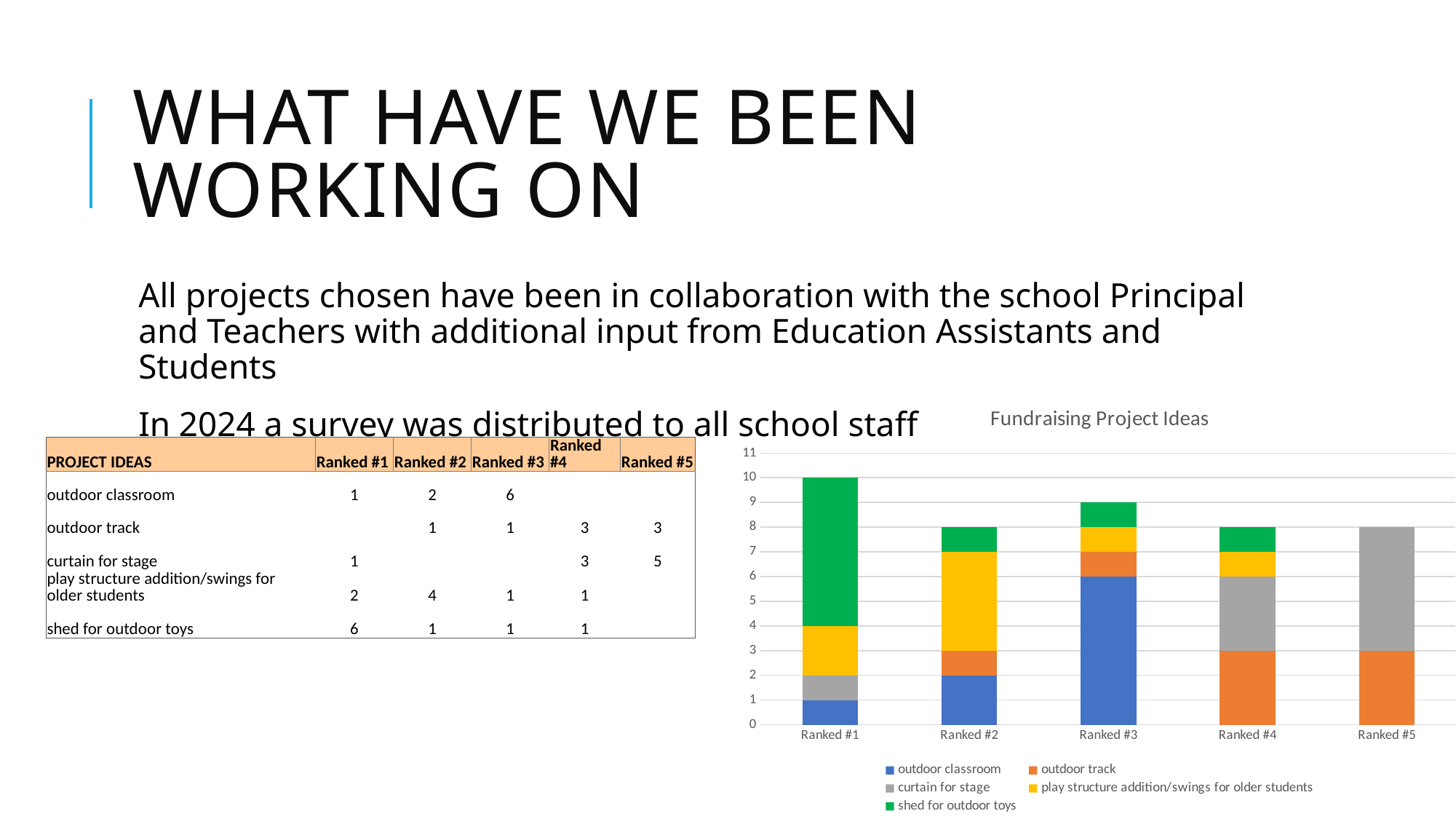
What kind of chart is shown on the slide? Stacked bar chart What is the total height of the stacked bar for Ranked #1? 10 What is the title of the chart? Fundraising Project Ideas What is the value for outdoor classroom in the Ranked #3 bar? 6 Which ranking category has the tallest stacked bar? Ranked #1 How many series does the chart's legend list? 5 How many ranking categories are shown on the x axis of the chart? 5 What is the total height of the stacked bar for Ranked #3? 9 What is the difference between the total of the Ranked #1 bar and the total of the Ranked #3 bar? 1 What is the value for curtain for stage in the Ranked #5 bar? 5 What is the value for shed for outdoor toys in the Ranked #1 bar? 6 Which stacked bar is taller, Ranked #1 or Ranked #2? Ranked #1